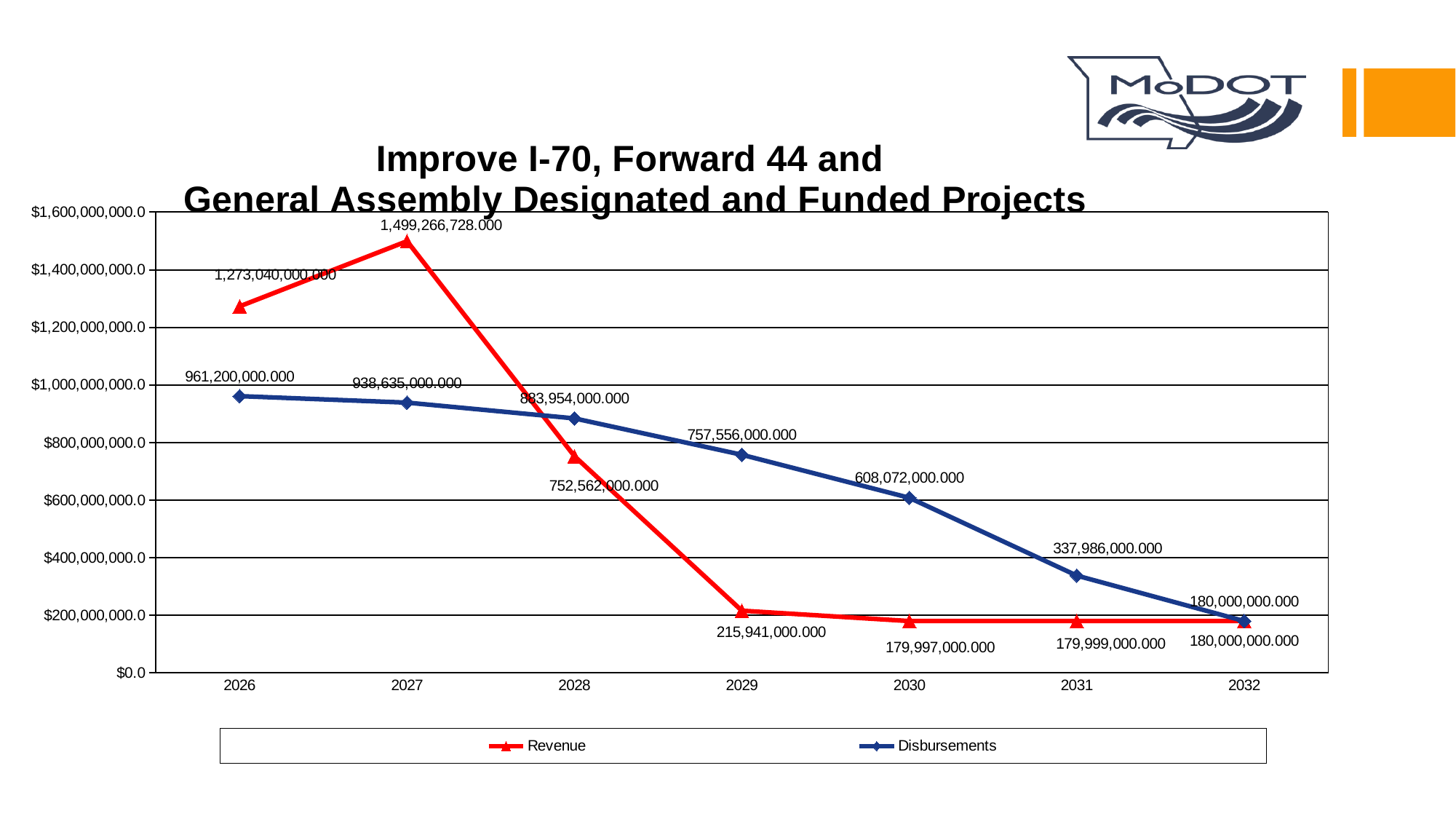
How many series does the legend list? 2 How many years are plotted on the x axis? 7 What is the Disbursements value for 2030? 608,072,000.000 In which year is Revenue highest? 2027 What is the difference between Disbursements in 2026 and 2027? 22,565,000.000 What is the difference between Revenue and Disbursements in 2026? 311,840,000.000 Is the Disbursements value for 2029 greater or less than $800,000,000.0? less What kind of chart is shown on the slide? line chart In which year are Disbursements lowest? 2032 What is the Revenue value for 2027? 1,499,266,728.000 Do Disbursements rise or fall from 2026 to 2032? fall In 2028, which is larger, Revenue or Disbursements? Disbursements